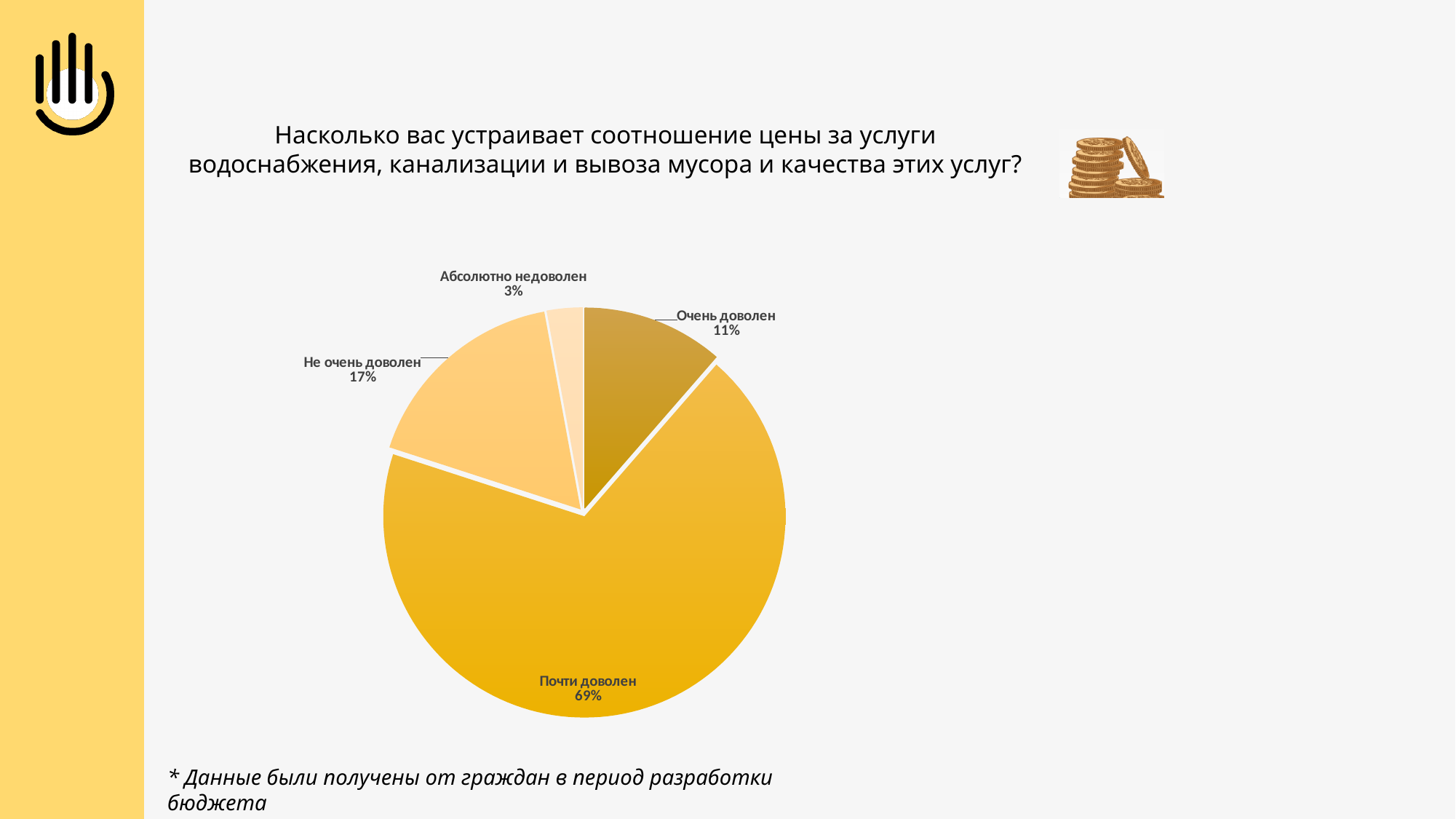
What is the value shown for "Не очень доволен"? 17% Which is larger, the share for "Очень доволен" or for "Не очень доволен"? Не очень доволен What kind of chart is shown on the slide? Pie chart What is the value shown for "Очень доволен"? 11% What is the difference between the shares of "Не очень доволен" and "Очень доволен"? 6% Which category has the smallest slice of the pie? Абсолютно недоволен What is the combined share of "Очень доволен" and "Почти доволен"? 80% How many categories are shown in the pie chart? 4 What is the value shown for "Абсолютно недоволен"? 3% What is the difference between the shares of "Почти доволен" and "Не очень доволен"? 52% Which category has the largest slice of the pie? Почти доволен What share of the pie does "Почти доволен" represent? 69%